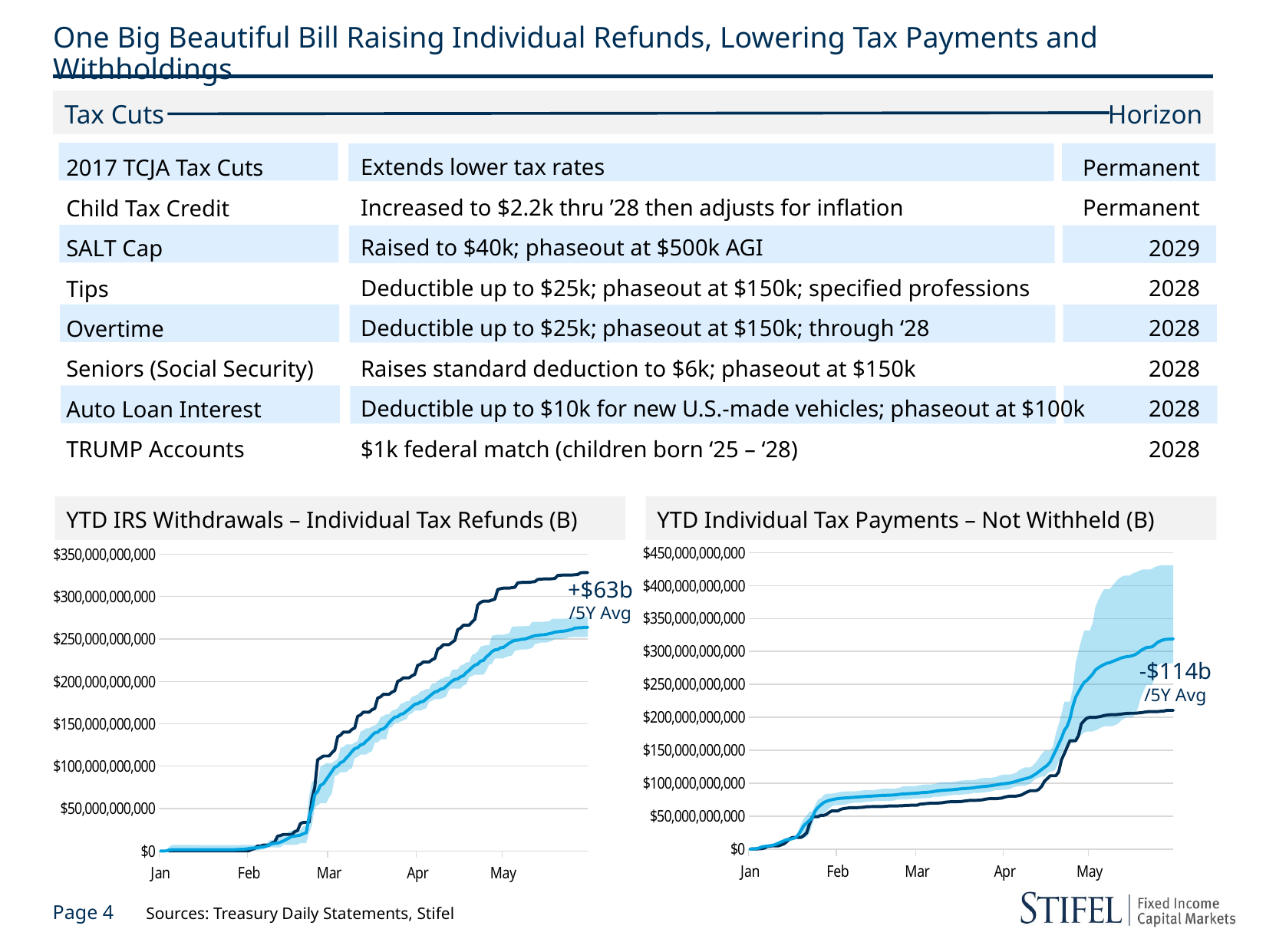
In the 'YTD Individual Tax Payments – Not Withheld (B)' chart, do the values rise or fall from Jan to May? rise In the 'YTD IRS Withdrawals – Individual Tax Refunds (B)' chart, which line is higher at the end of May, the dark navy line or the light blue line? the dark navy line What kind of chart is the 'YTD IRS Withdrawals – Individual Tax Refunds (B)' chart? line chart In the 'YTD Individual Tax Payments – Not Withheld (B)' chart, is the value of the dark navy line at the end of May greater or less than $250,000,000,000? less What is the highest value shown on the y axis of the 'YTD Individual Tax Payments – Not Withheld (B)' chart? $450,000,000,000 In the 'YTD IRS Withdrawals – Individual Tax Refunds (B)' chart, do the values rise or fall from Jan to May? rise How many months are labeled on the x axis of the 'YTD IRS Withdrawals – Individual Tax Refunds (B)' chart? 5 In the 'YTD IRS Withdrawals – Individual Tax Refunds (B)' chart, is the value of the dark navy line at the end of May greater or less than $300,000,000,000? greater What is the title of the chart on the right side of the slide? YTD Individual Tax Payments – Not Withheld (B) In the 'YTD IRS Withdrawals – Individual Tax Refunds (B)' chart, what difference versus the 5Y average is annotated at the end of the line? +$63b In the 'YTD IRS Withdrawals – Individual Tax Refunds (B)' chart, is the value of the light blue line at the end of May greater or less than $300,000,000,000? less In the 'YTD Individual Tax Payments – Not Withheld (B)' chart, what difference versus the 5Y average is annotated at the end of the line? -$114b